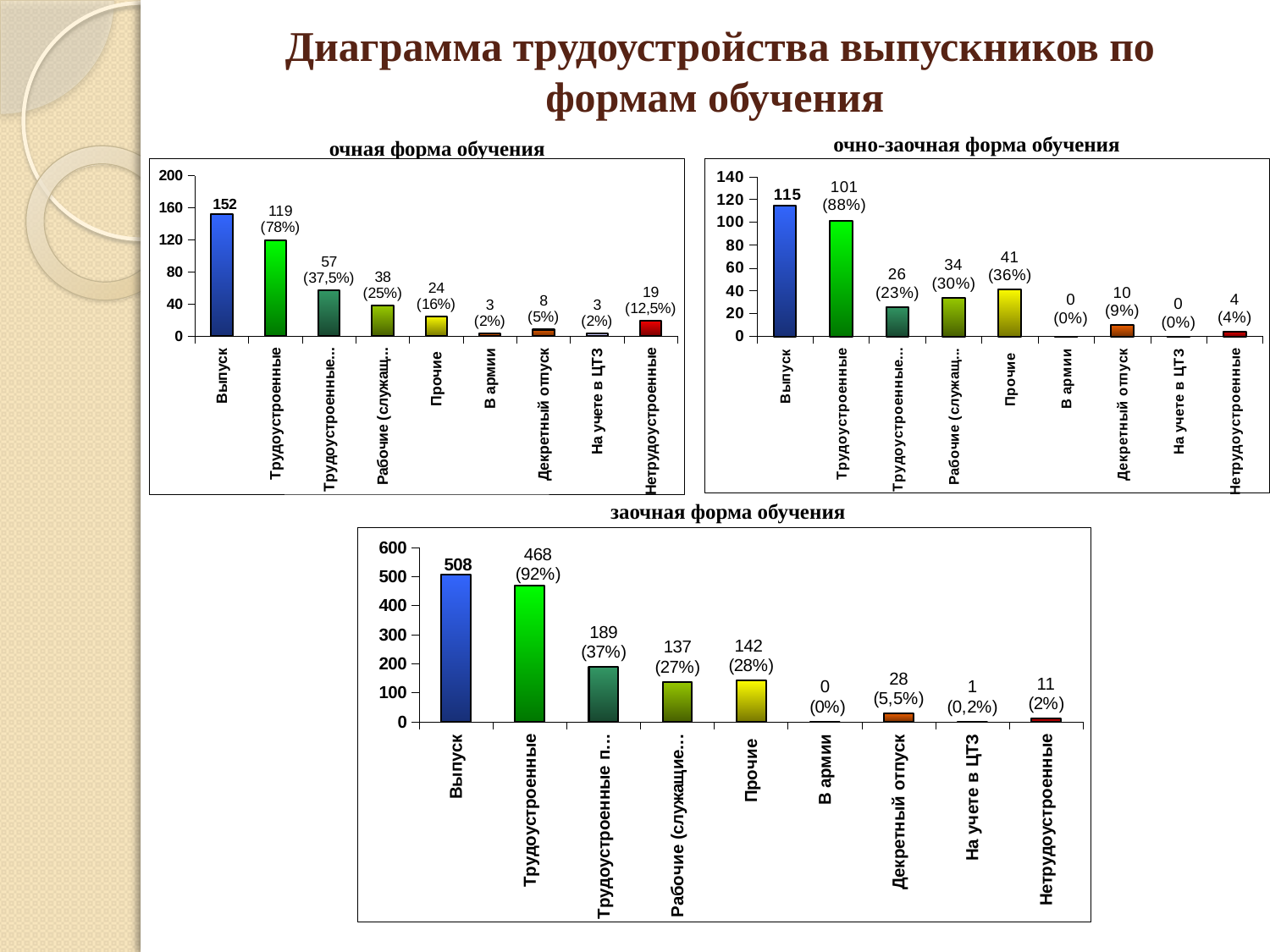
In the chart titled "очно-заочная форма обучения", how many categories are shown on the x axis? 9 In the chart titled "очно-заочная форма обучения", what is the value for Прочие? 41 In the chart titled "заочная форма обучения", what is the difference between Выпуск and Трудоустроенные? 40 How many charts are shown on the slide? 3 In the chart titled "очная форма обучения", which is larger: Прочие or Декретный отпуск? Прочие In the chart titled "очная форма обучения", what is the value for Выпуск? 152 In the chart titled "очная форма обучения", what percentage is shown for Трудоустроенные? 78% In the chart titled "очно-заочная форма обучения", what is the value for Декретный отпуск? 10 In the chart titled "заочная форма обучения", which category has the highest value? Выпуск In the chart titled "очная форма обучения", what is the value for Нетрудоустроенные? 19 In the chart titled "заочная форма обучения", what is the value for Трудоустроенные? 468 What type of chart is the chart titled "заочная форма обучения"? Bar chart